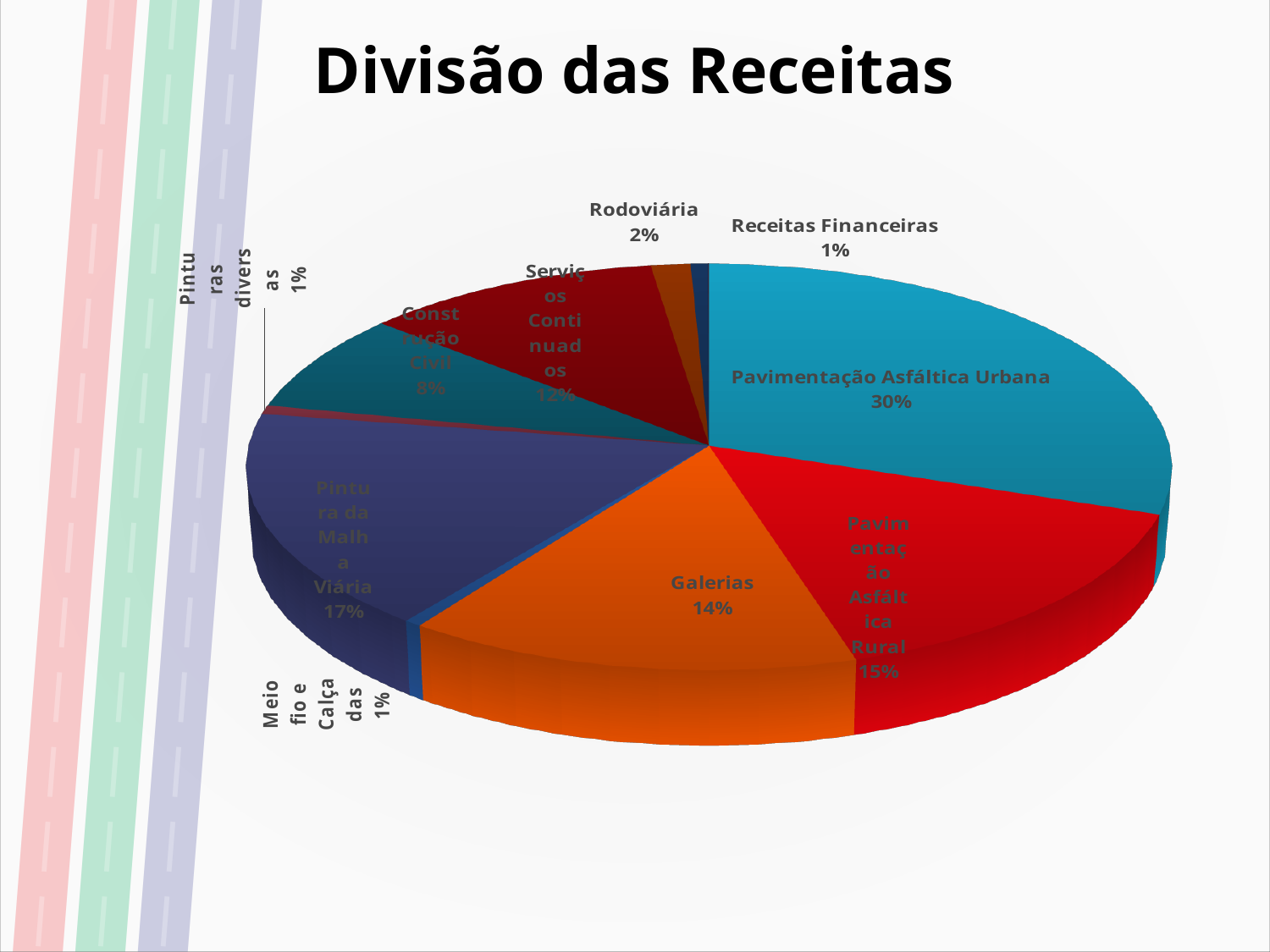
What percentage is shown for Serviços Continuados? 12% What percentage is shown for Pintura da Malha Viária? 17% What kind of chart is shown on the slide? pie chart What percentage is shown for Rodoviária? 2% What is the difference in percentage points between Pavimentação Asfáltica Urbana and Pintura da Malha Viária? 13 What share of the pie does Pavimentação Asfáltica Urbana represent? 30% What percentage is shown for Construção Civil? 8% Which is larger, Pavimentação Asfáltica Rural or Galerias? Pavimentação Asfáltica Rural What is the title of the chart? Divisão das Receitas Which category has the largest share of the pie? Pavimentação Asfáltica Urbana What percentage is shown for Galerias? 14% How many slices does the pie chart have? 10